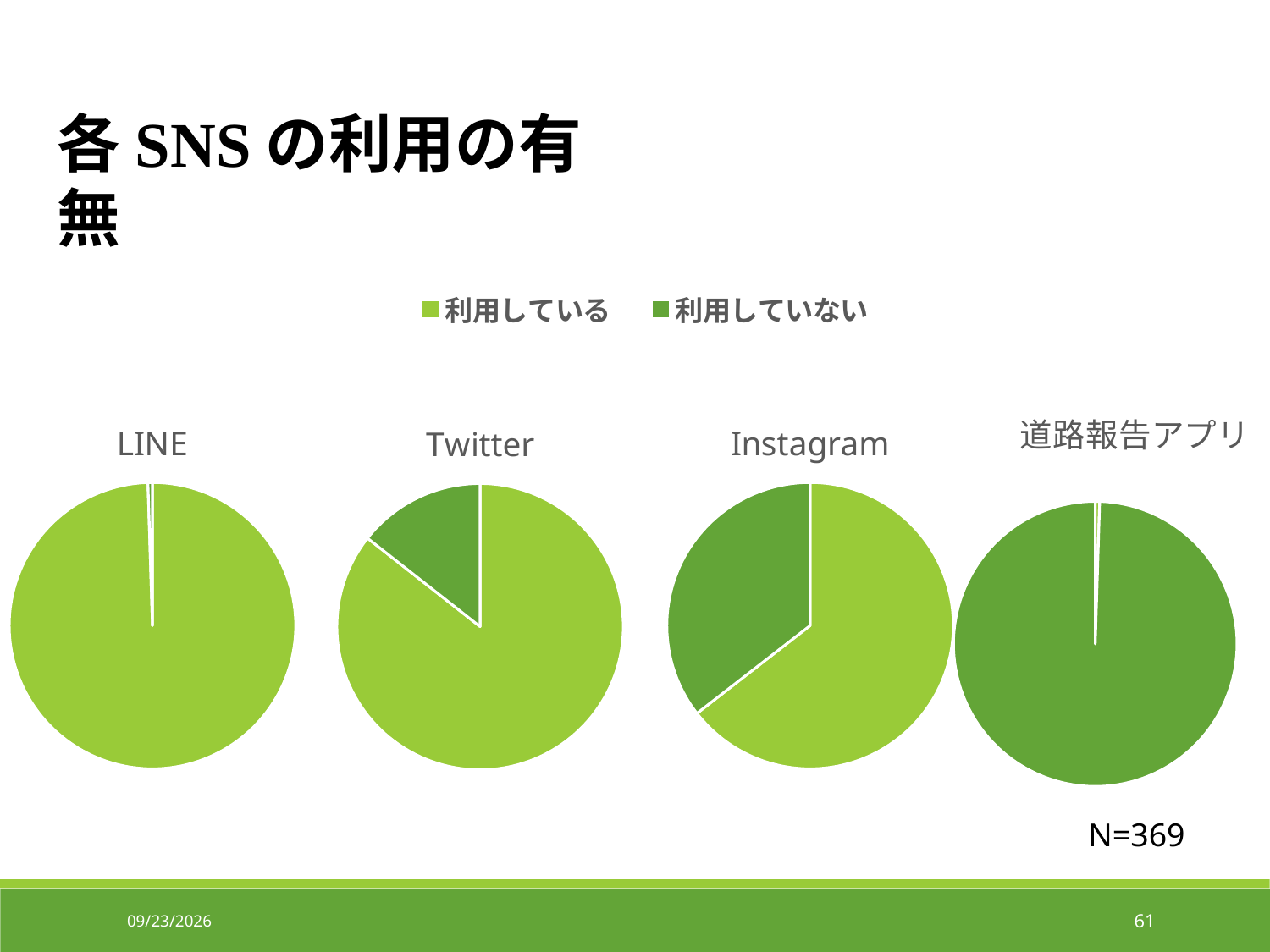
Which of the four pie charts has the largest 利用している slice? LINE What are the two legend entries shown above the pie charts? 利用している, 利用していない What sample size (N) is stated on the slide? N=369 In the LINE pie chart, which slice is larger: 利用している or 利用していない? 利用している What is the title of the pie chart on the far right of the slide? 道路報告アプリ In the 道路報告アプリ pie chart, which slice is larger: 利用している or 利用していない? 利用していない In the Twitter pie chart, which slice is larger: 利用している or 利用していない? 利用している What kind of chart is used for LINE on this slide? Pie chart How many entries does the shared legend list? 2 How many pie charts are shown on the slide? 4 Which of the four pie charts has the largest 利用していない slice? 道路報告アプリ